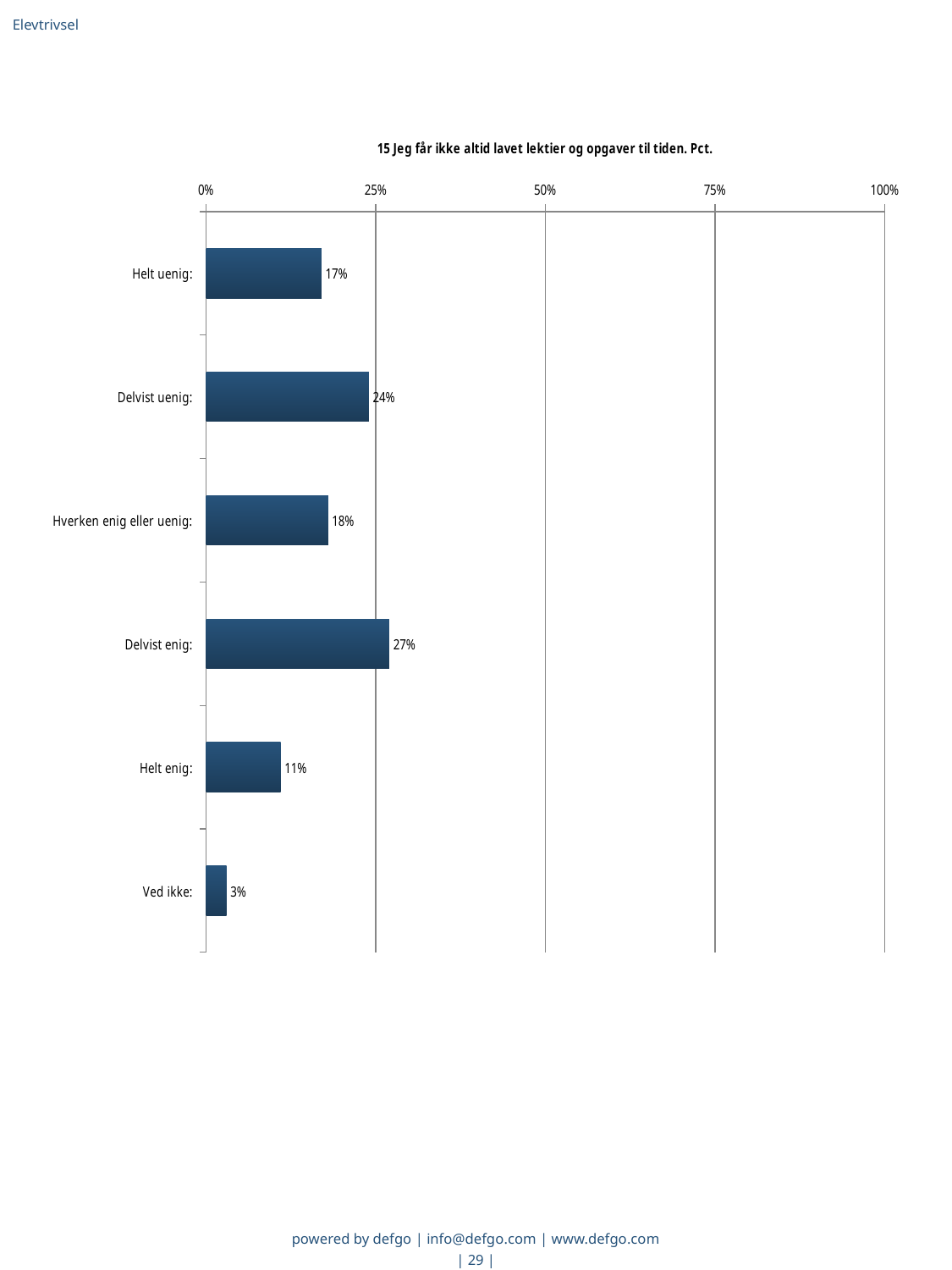
What is the value for "Helt uenig"? 17% Which category has the highest value? Delvist enig Which category has the lowest value? Ved ikke What is the value for "Hverken enig eller uenig"? 18% What is the value for "Ved ikke"? 3% What kind of chart is shown on the slide? Bar chart How many categories are shown in the chart? 6 What is the value for "Delvist enig"? 27% Which is larger, the value for "Delvist uenig" or the value for "Helt uenig"? Delvist uenig What is the difference between the values for "Delvist enig" and "Helt enig"? 16% Is the value for "Delvist enig" greater or less than 25%? greater What is the title of the chart? 15 Jeg får ikke altid lavet lektier og opgaver til tiden. Pct.